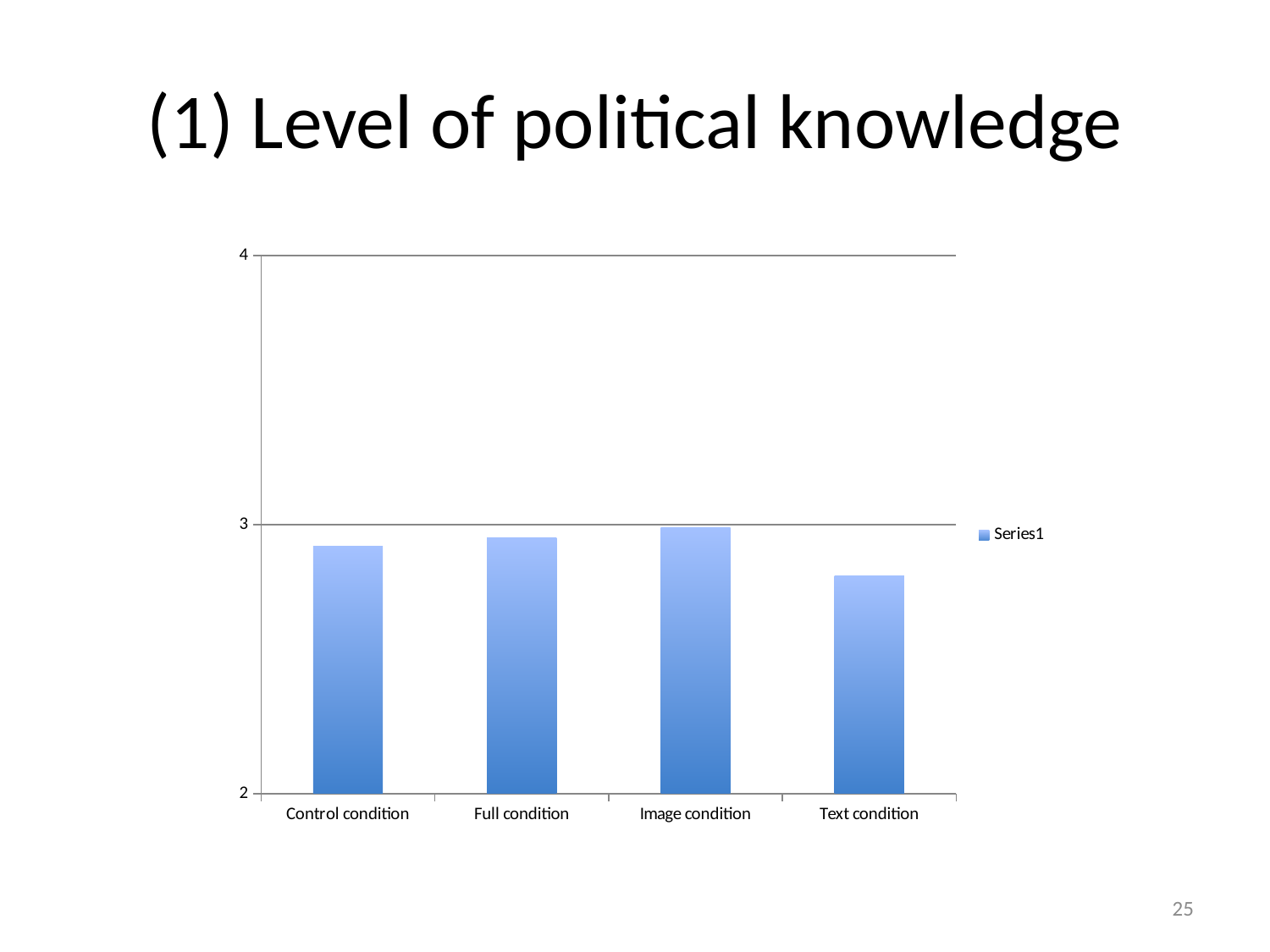
What is the name of the series listed in the chart's legend? Series1 Which is larger, the value for Control condition or the value for Text condition? Control condition Is the value for Control condition greater or less than 3? less How many series does the chart's legend list? 1 What kind of chart is shown on the slide? Bar chart What is the title of the slide containing the chart? (1) Level of political knowledge Which condition has the lowest bar in the chart? Text condition Is the value for Text condition greater or less than 3? less Is the value for Image condition greater or less than 2? greater Which is larger, the value for Image condition or the value for Text condition? Image condition How many categories are shown on the x axis of the chart? 4